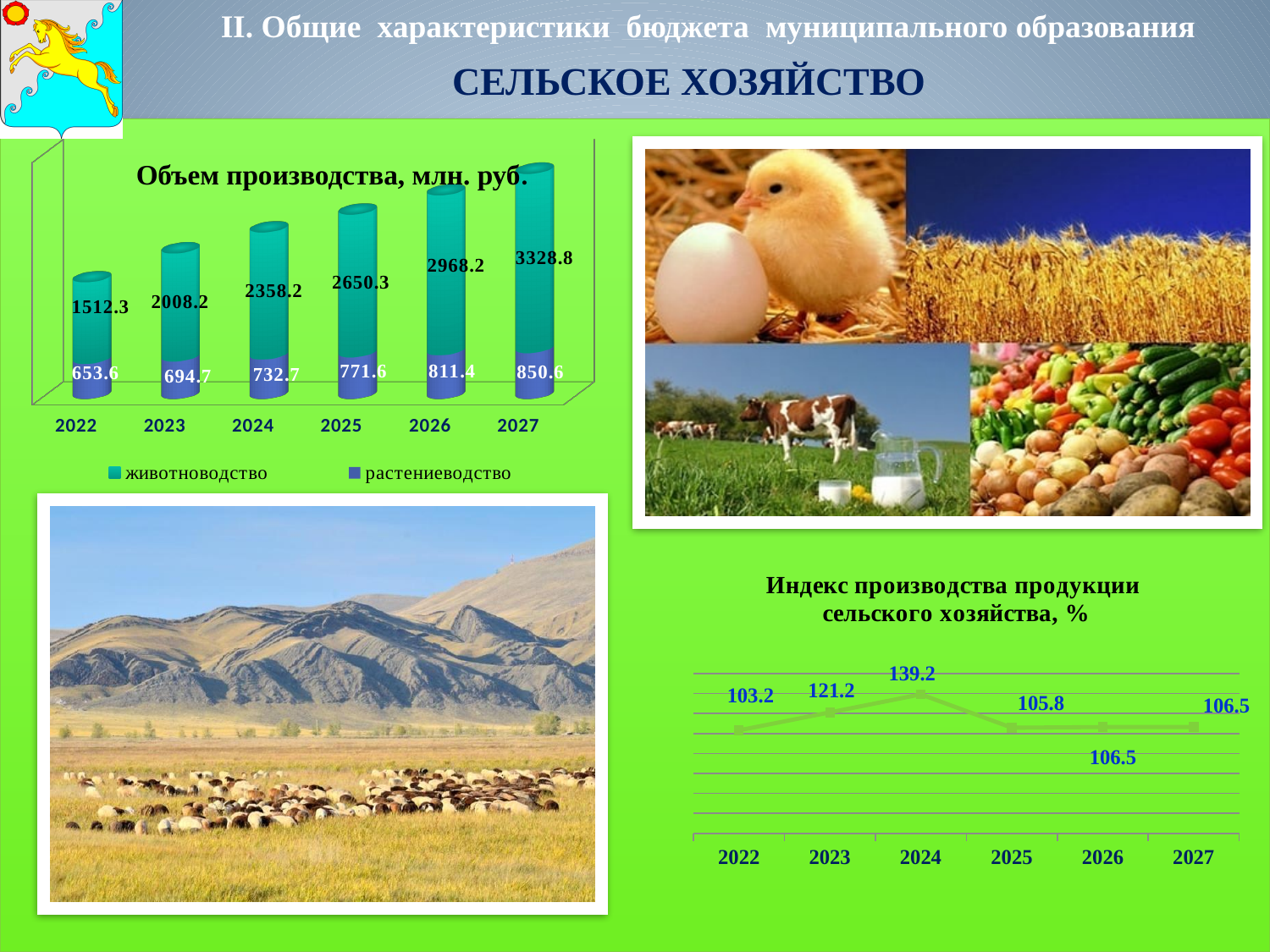
In the chart 'Объем производства, млн. руб.', what is the value for растениеводство in 2026? 811.4 In the chart 'Индекс производства продукции сельского хозяйства, %', what is the difference between the 2024 and 2022 values? 36.0 In the chart 'Объем производства, млн. руб.', how many series does the legend list? 2 What kind of chart is 'Объем производства, млн. руб.'? Stacked bar chart In the chart 'Объем производства, млн. руб.', which year has the highest value for животноводство? 2027 In the chart 'Объем производства, млн. руб.', which year has the lowest value for растениеводство? 2022 In the chart 'Индекс производства продукции сельского хозяйства, %', what is the value for 2023? 121.2 In the chart 'Индекс производства продукции сельского хозяйства, %', which year has the highest value? 2024 In the chart 'Индекс производства продукции сельского хозяйства, %', how many years are plotted on the x axis? 6 In the chart 'Объем производства, млн. руб.', by how much does животноводство in 2027 exceed животноводство in 2022? 1816.5 In the chart 'Объем производства, млн. руб.', what is the total of the stacked bar for 2022? 2165.9 In the chart 'Объем производства, млн. руб.', what is the value for животноводство in 2024? 2358.2